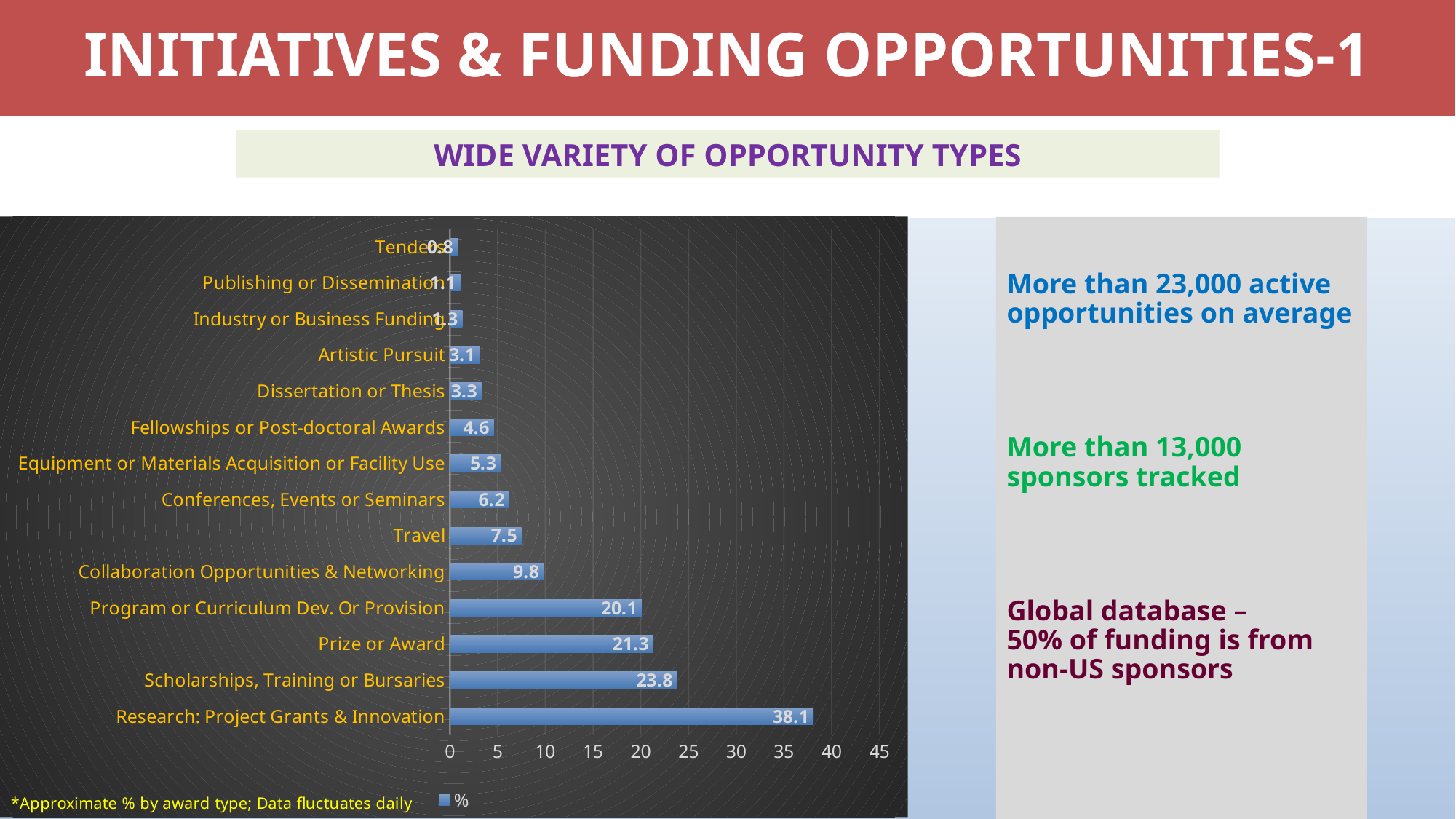
What is the legend entry for the series in the chart? % Which category has the highest value? Research: Project Grants & Innovation Is the value for Scholarships, Training or Bursaries greater or less than 20? greater What is the value for Research: Project Grants & Innovation? 38.1 Which is larger, the value for Conferences, Events or Seminars or the value for Fellowships or Post-doctoral Awards? Conferences, Events or Seminars What type of chart is shown on the slide? bar chart What is the value for Scholarships, Training or Bursaries? 23.8 What is the value for Travel? 7.5 What is the difference between the values for Prize or Award and Program or Curriculum Dev. Or Provision? 1.2 What is the value for Collaboration Opportunities & Networking? 9.8 How many categories are shown in the chart? 14 How many series does the legend list? 1